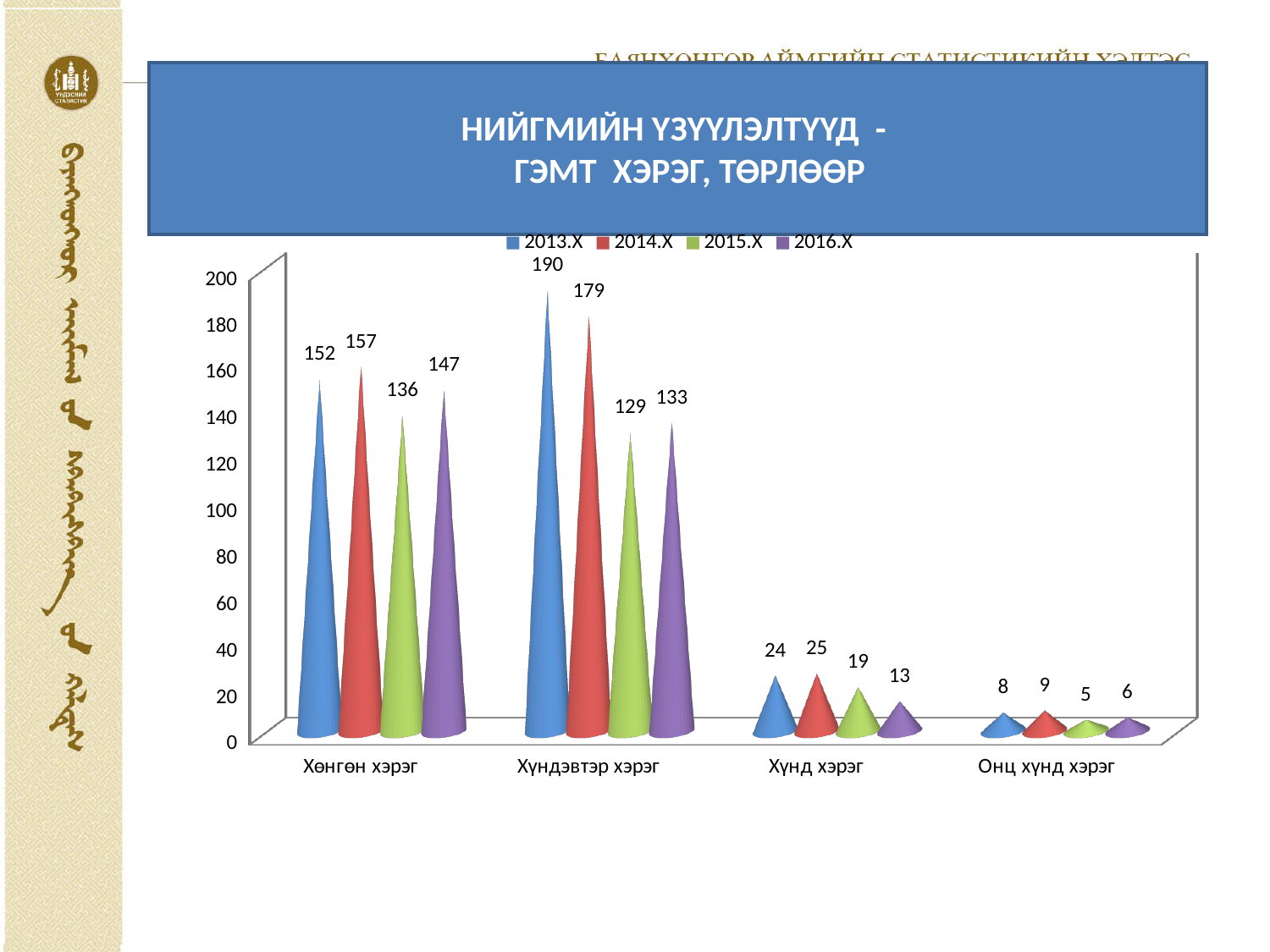
What is the value for 2014.X in the Онц хүнд хэрэг category? 9 Which series is shown in red in the legend? 2014.X Which series has the lowest value in the Онц хүнд хэрэг category? 2015.X What is the value for 2016.X in the Хүнд хэрэг category? 13 What kind of chart is shown on the slide? Bar chart What is the difference between the 2013.X and 2014.X values in the Хүндэвтэр хэрэг category? 11 Which is larger in the Хөнгөн хэрэг category: the 2014.X value or the 2016.X value? 2014.X What is the value for 2015.X in the Хөнгөн хэрэг category? 136 What is the value for 2013.X in the Хүндэвтэр хэрэг category? 190 How many series does the legend list? 4 How many categories are shown on the x axis? 4 Which series has the highest value in the Хүндэвтэр хэрэг category? 2013.X